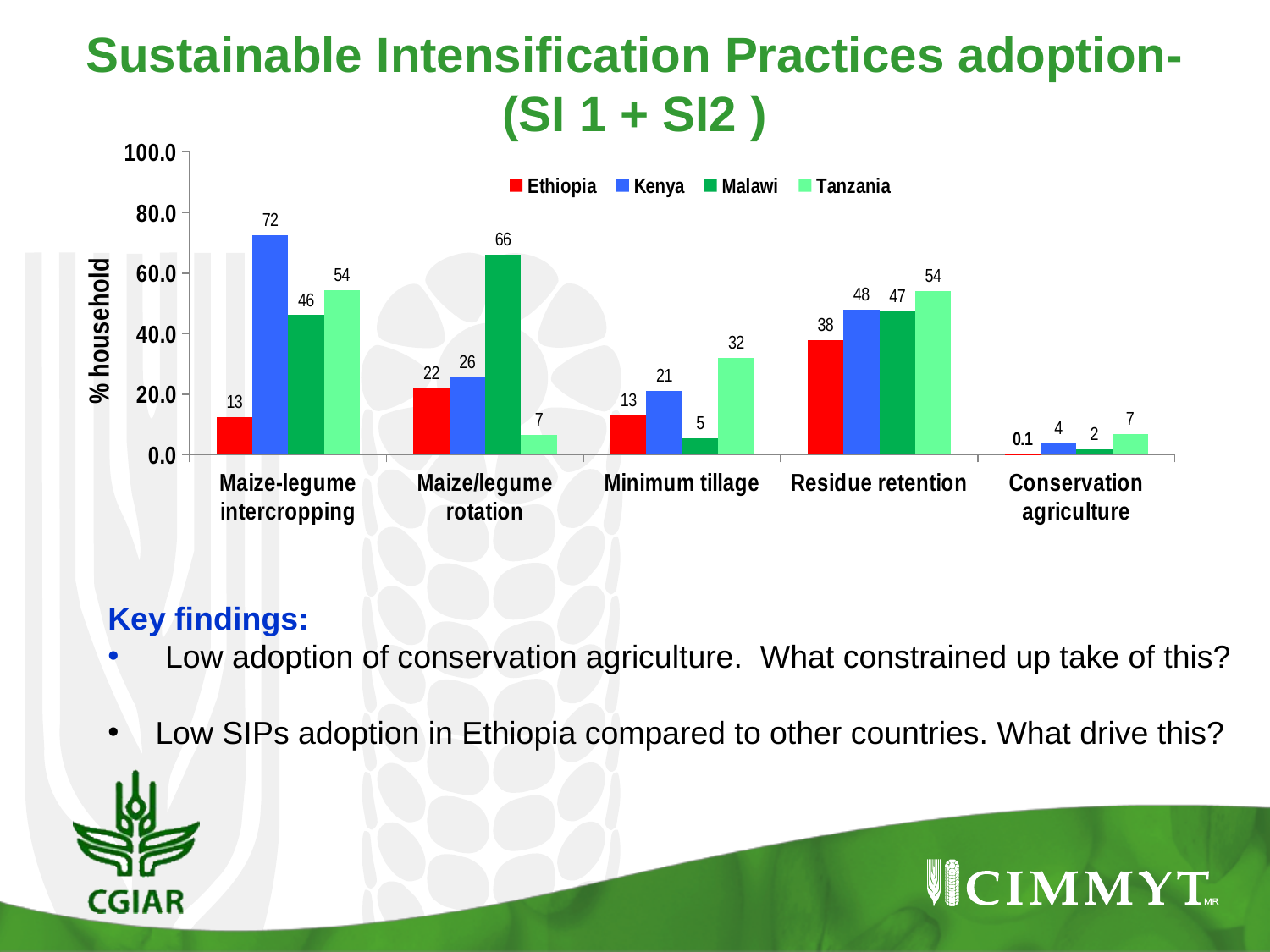
What is the value for Kenya in the Maize-legume intercropping category? 72 What is the label of the y axis? % household What is the value for Ethiopia in the Conservation agriculture category? 0.1 Which country has the lowest value for Residue retention? Ethiopia Which is larger for Residue retention: the value for Kenya or the value for Malawi? Kenya What is the value for Malawi in the Maize/legume rotation category? 66 How many practice categories are shown on the x axis? 5 Is the value for Tanzania in Minimum tillage greater or less than 20.0? greater Which country has the highest value for Minimum tillage? Tanzania How many series does the legend list? 4 What kind of chart is shown on the slide? bar chart What is the difference between the Kenya and Ethiopia values for Maize-legume intercropping? 59